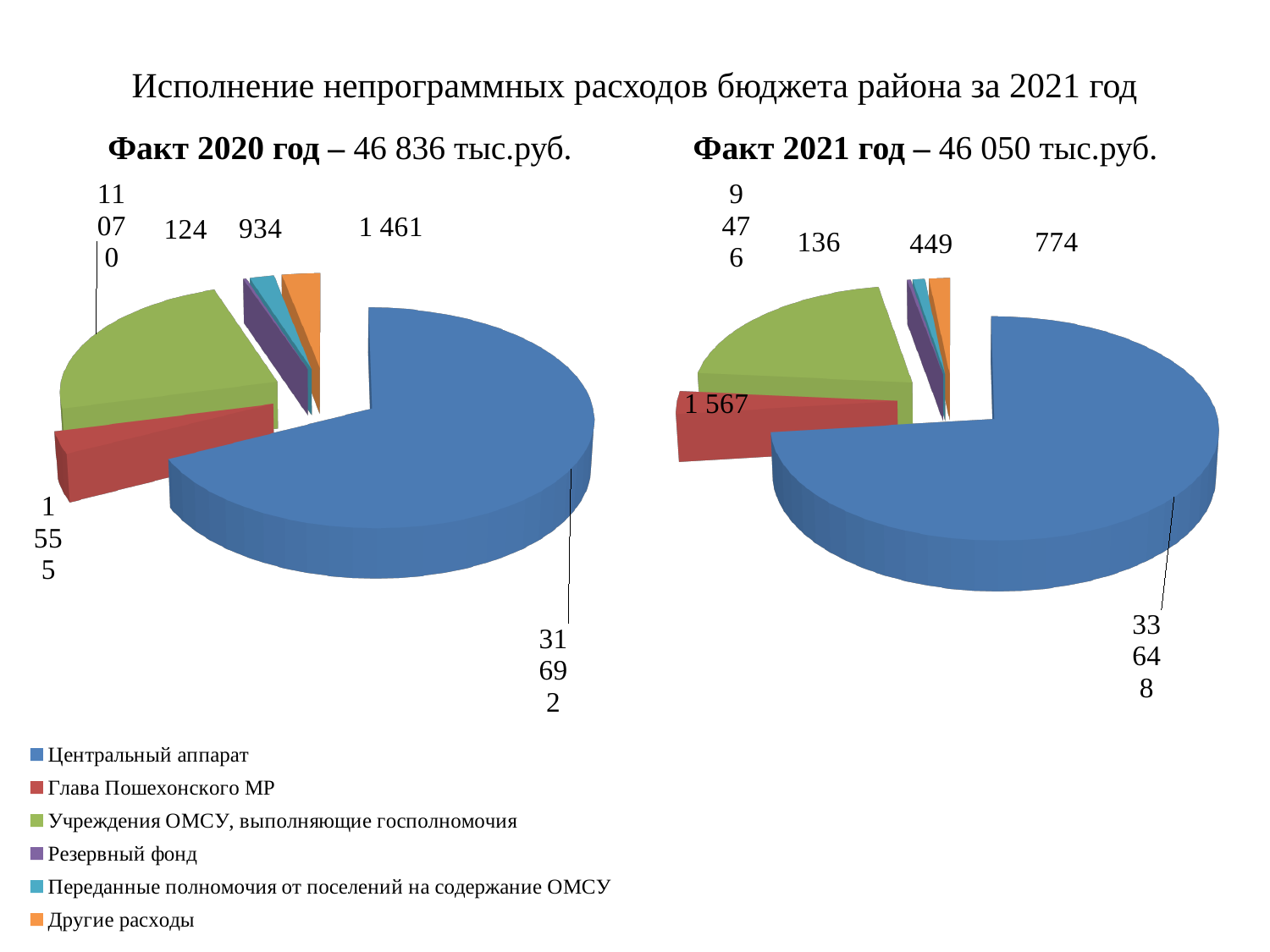
In the 'Факт 2020 год' chart, what is the value for Резервный фонд? 124 What is the difference between the Центральный аппарат value in the 'Факт 2021 год' chart and in the 'Факт 2020 год' chart? 1 956 In the 'Факт 2021 год' chart, what is the value for Глава Пошехонского МР? 1 567 In the 'Факт 2021 год' chart, which category has the largest slice? Центральный аппарат How many series does the legend list? 6 In the 'Факт 2020 год' chart, which category has the smallest slice? Резервный фонд What type of charts are shown on the slide? Pie charts In the 'Факт 2021 год' chart, what is the value for Учреждения ОМСУ, выполняющие госполномочия? 9 476 What total is stated in the title of the 'Факт 2021 год' chart? 46 050 тыс.руб. In the 'Факт 2020 год' chart, what is the value for Центральный аппарат? 31 692 How many slices does the 'Факт 2021 год' pie chart have? 6 In the 'Факт 2020 год' chart, which is larger: Другие расходы or Переданные полномочия от поселений на содержание ОМСУ? Другие расходы